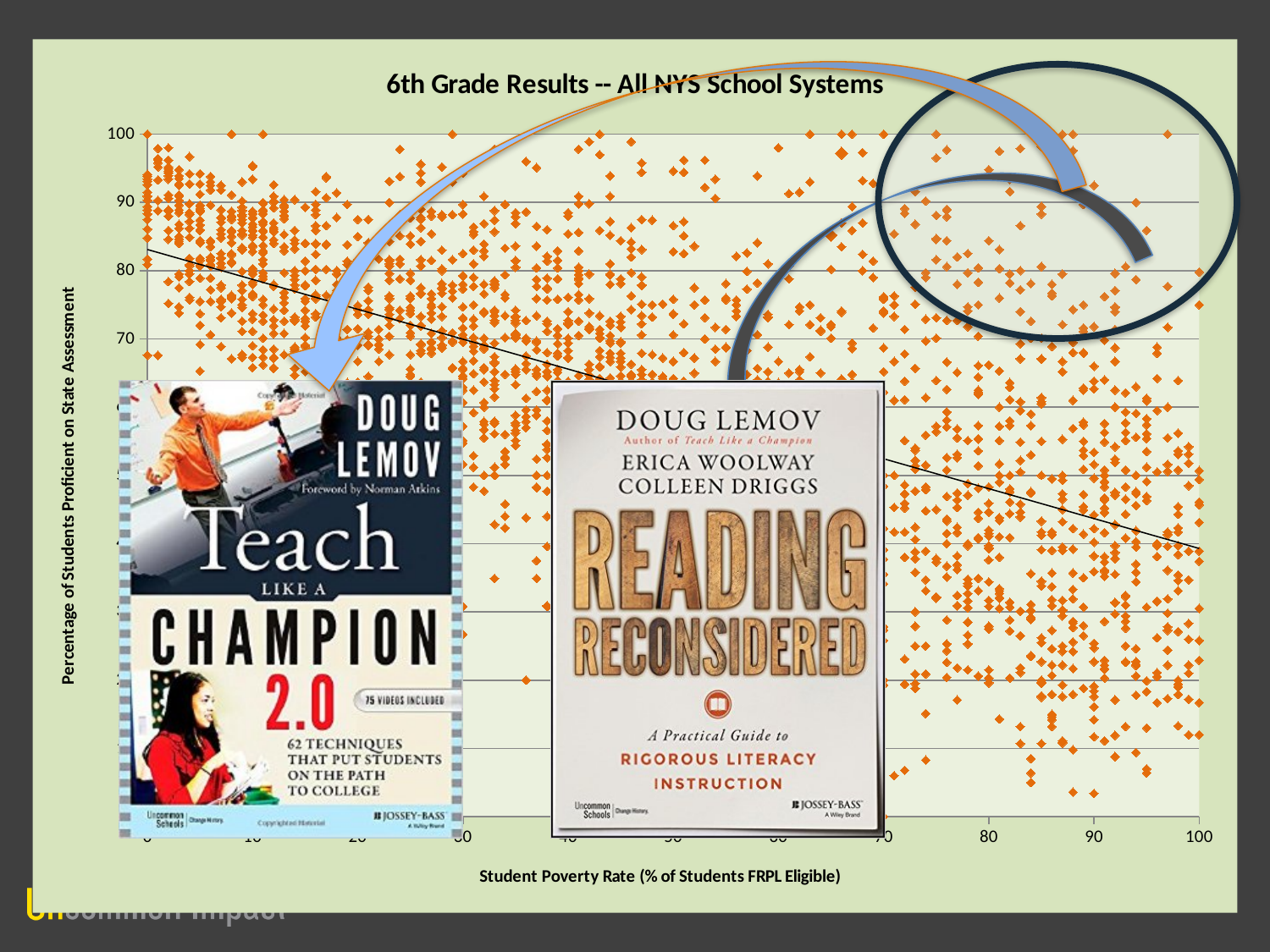
What is the title of the chart? 6th Grade Results -- All NYS School Systems What is the highest value shown on the y axis? 100 What is the highest value shown on the x axis? 100 As the student poverty rate increases along the x axis, do the proficiency percentages generally rise or fall? fall What kind of chart is shown on the slide? scatter plot Does the trend line drawn through the points slope upward or downward from left to right? downward